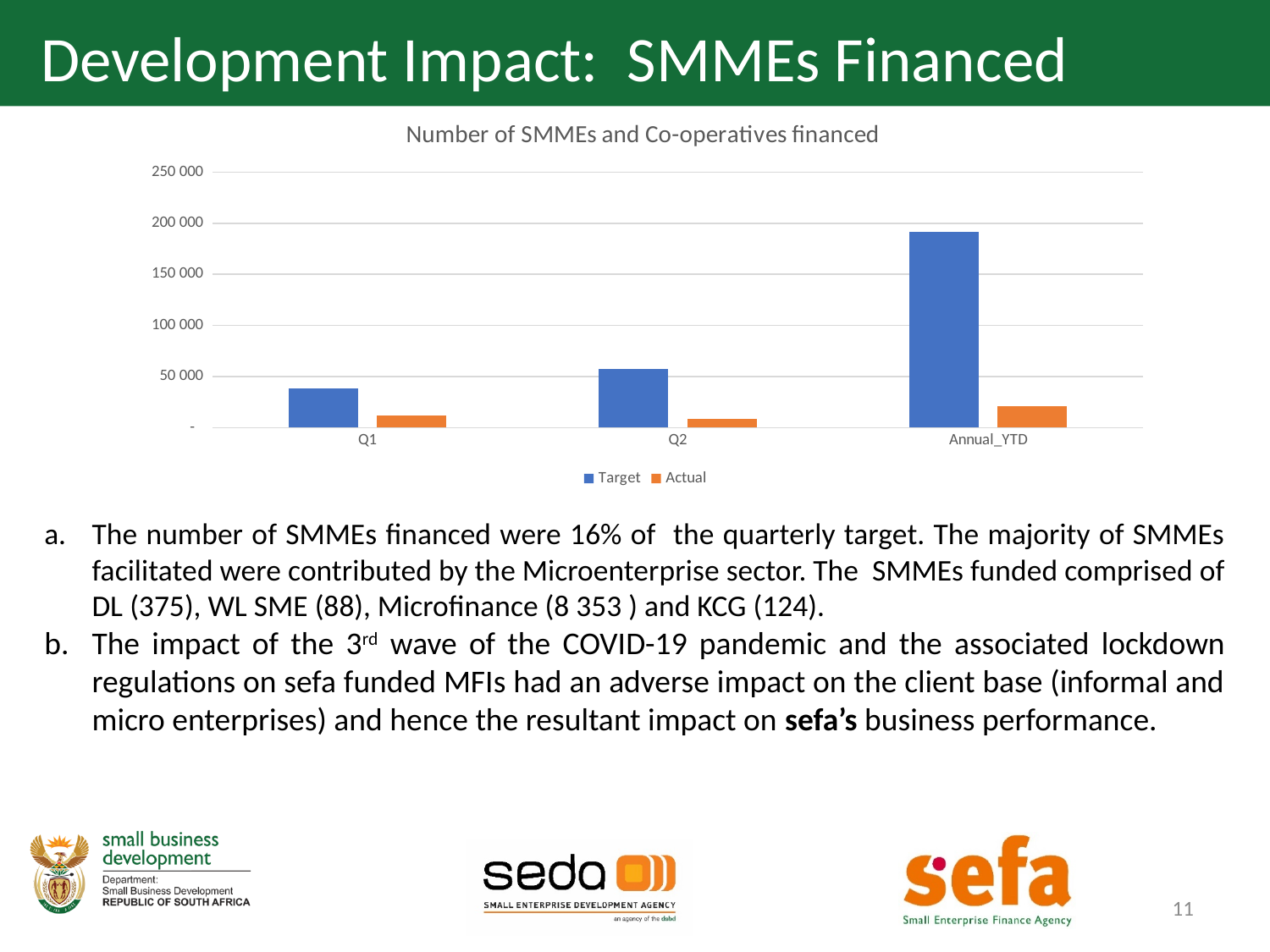
Is the Target value for Q1 greater or less than 50 000? less Is the Actual value for Annual_YTD greater or less than 50 000? less Which category has the highest Target value? Annual_YTD How many series does the chart legend list? 2 Which is larger, the Target value for Q2 or the Target value for Q1? Q2 Which category has the lowest Target value? Q1 What is the title of the chart? Number of SMMEs and Co-operatives financed How many categories are shown on the x axis of the chart? 3 Which colour represents the Actual series in the chart? orange Is the Target value for Q2 greater or less than 50 000? greater What kind of chart is shown on the slide? bar chart